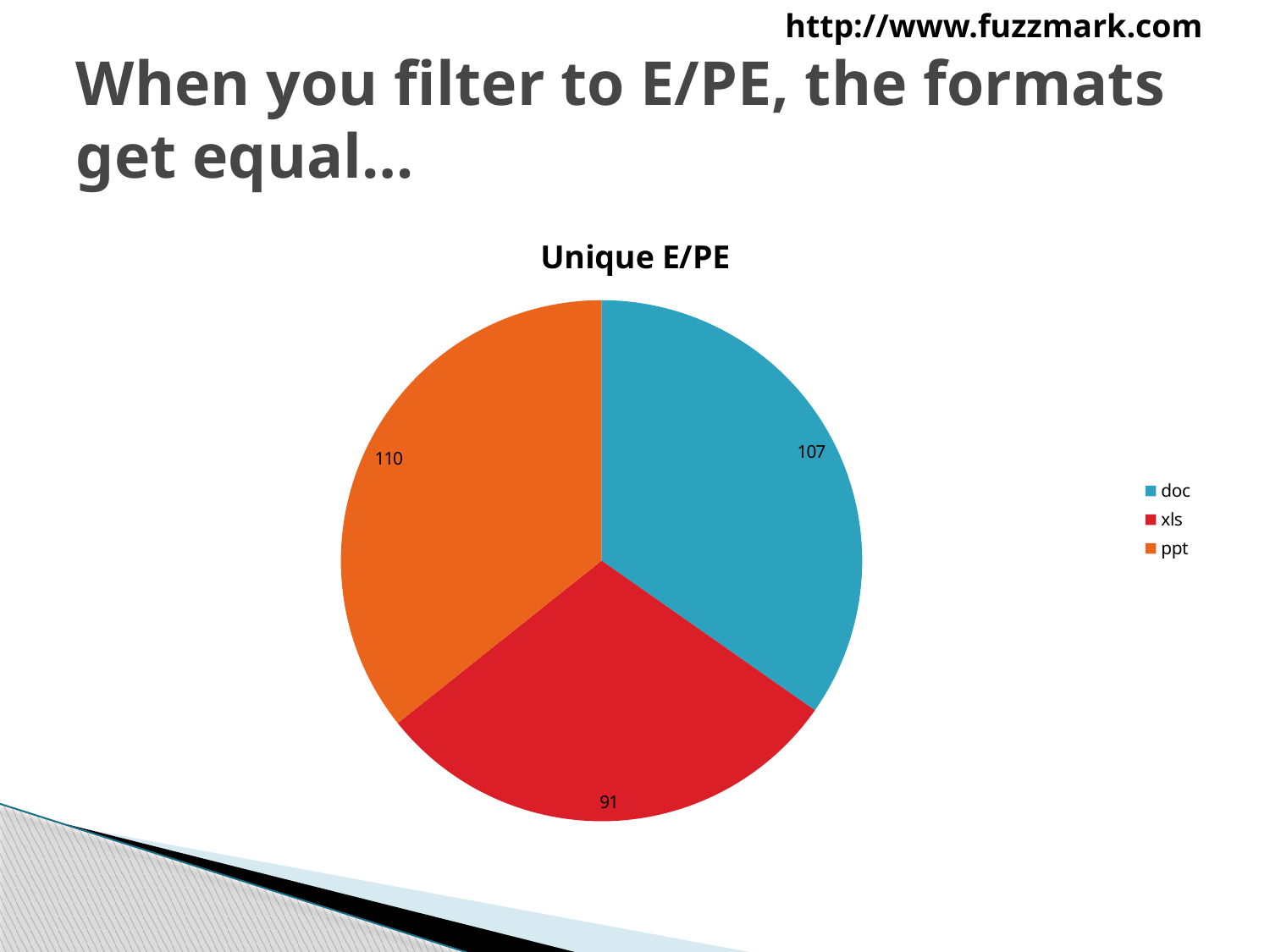
What is the value for ppt? 110 What is the value for xls? 91 What type of chart is shown on the slide? pie chart What is the difference between the values for ppt and xls? 19 Which is larger, the value for doc or the value for ppt? ppt What is the difference between the values for doc and xls? 16 How many slices does the pie chart have? 3 What is the total of all slices in the pie chart? 308 Which format has the largest slice? ppt What is the title of the chart? Unique E/PE Which format has the smallest slice? xls What is the value for doc? 107